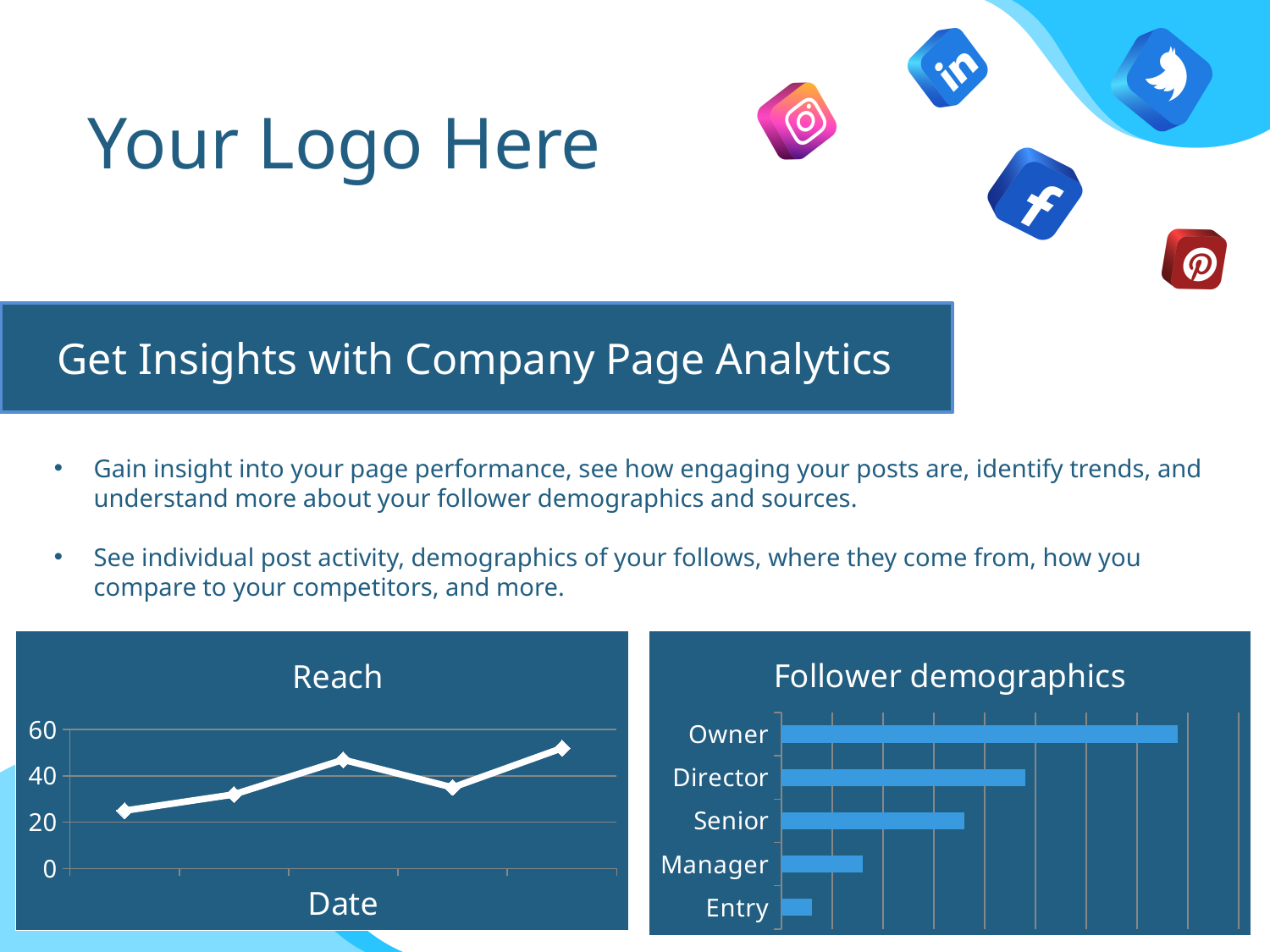
On the Reach chart, is the value of the fourth point greater or less than 40? less On the Follower demographics chart, which is larger, Director or Senior? Director On the Follower demographics chart, which category has the shortest bar? Entry What kind of chart is the Reach chart? line chart What is the x-axis title of the Reach chart? Date On the Follower demographics chart, which is larger, Manager or Entry? Manager On the Reach chart, which point is the highest? the last (fifth) point What kind of chart is the Follower demographics chart? bar chart How many data points are plotted on the Reach chart? 5 On the Follower demographics chart, which category has the longest bar? Owner On the Reach chart, is the value of the first point greater or less than 20? greater How many categories are shown on the Follower demographics chart? 5